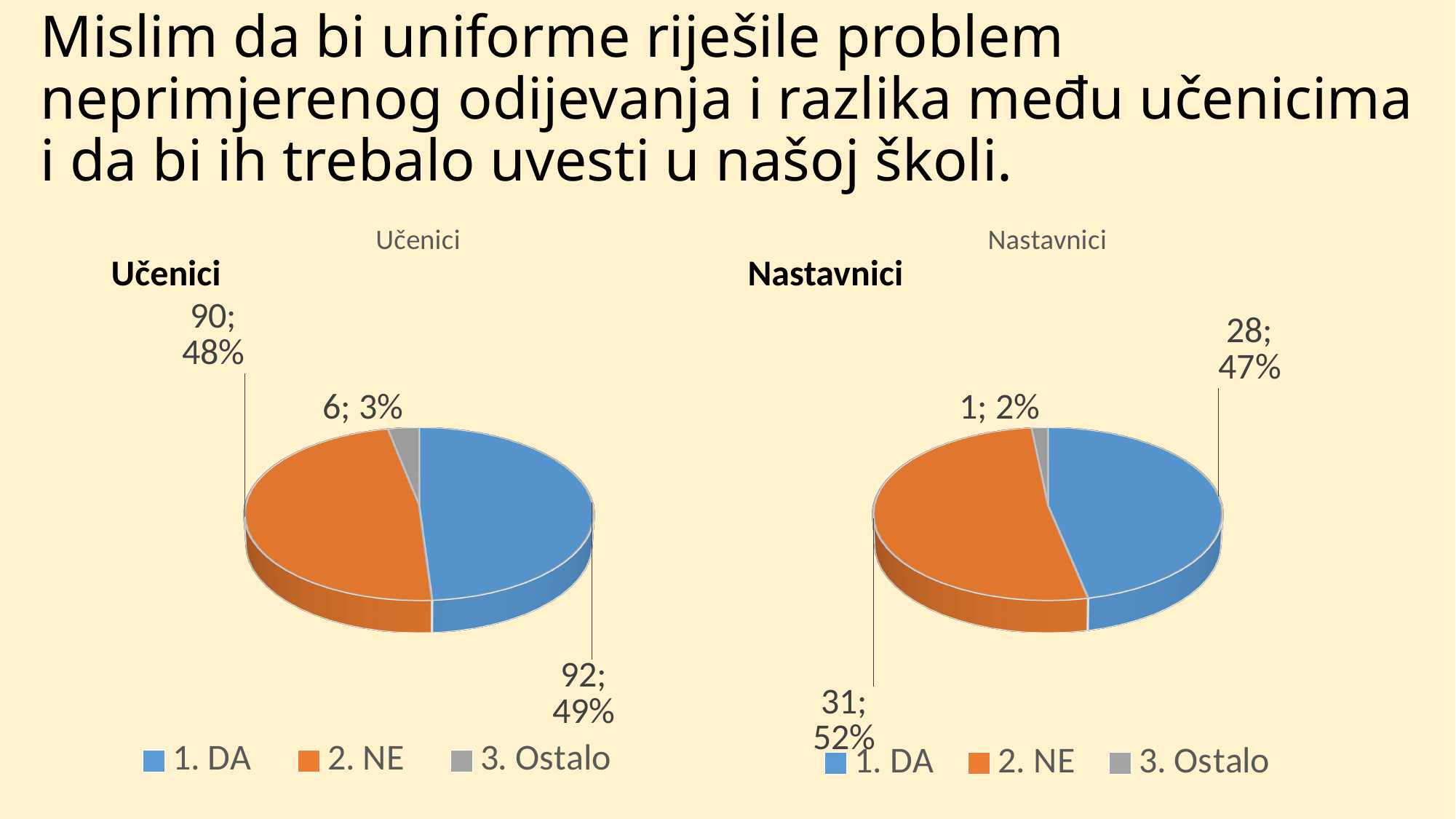
What type of chart is the Učenici chart? Pie chart In the Nastavnici chart, which category has the smallest slice? 3. Ostalo In the Nastavnici chart, which category has the largest slice? 2. NE In the Učenici chart, what percentage share does 2. NE have? 48% In the Nastavnici chart, how many respondents answered 2. NE? 31 In the Učenici chart, which category has the largest slice? 1. DA How many categories does the legend of the Nastavnici chart list? 3 In the Nastavnici chart, which is larger, the count for 1. DA or 2. NE? 2. NE In the Nastavnici chart, what percentage share does 1. DA have? 47% In the Učenici chart, how many respondents answered 1. DA? 92 In the Učenici chart, what colour is the 3. Ostalo slice? Grey In the Učenici chart, what is the difference between the counts for 1. DA and 2. NE? 2